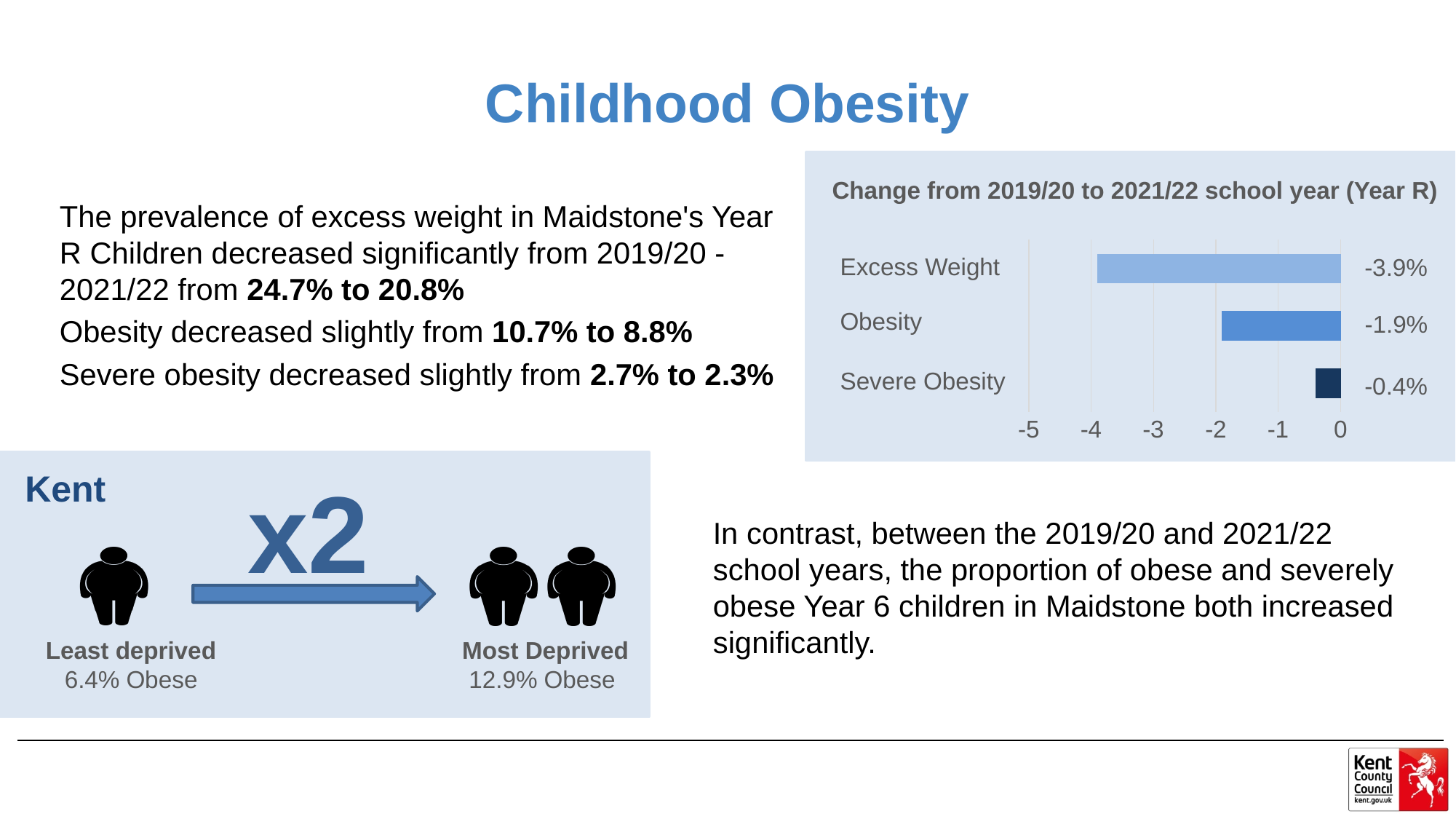
Which category shows the largest decrease in the chart? Excess Weight What is the lowest value shown on the chart's horizontal axis? -5 Is the value for Excess Weight greater or less than -3? less What is the change shown for Severe Obesity in the chart? -0.4% What is the change shown for Excess Weight in the chart? -3.9% What is the title of the chart? Change from 2019/20 to 2021/22 school year (Year R) Which category has a larger decrease, Obesity or Severe Obesity? Obesity Which category shows the smallest decrease in the chart? Severe Obesity What is the difference between the change for Excess Weight and the change for Obesity? 2.0 percentage points What kind of chart is shown on the slide? Bar chart What is the change shown for Obesity in the chart? -1.9% How many categories are shown in the chart? 3